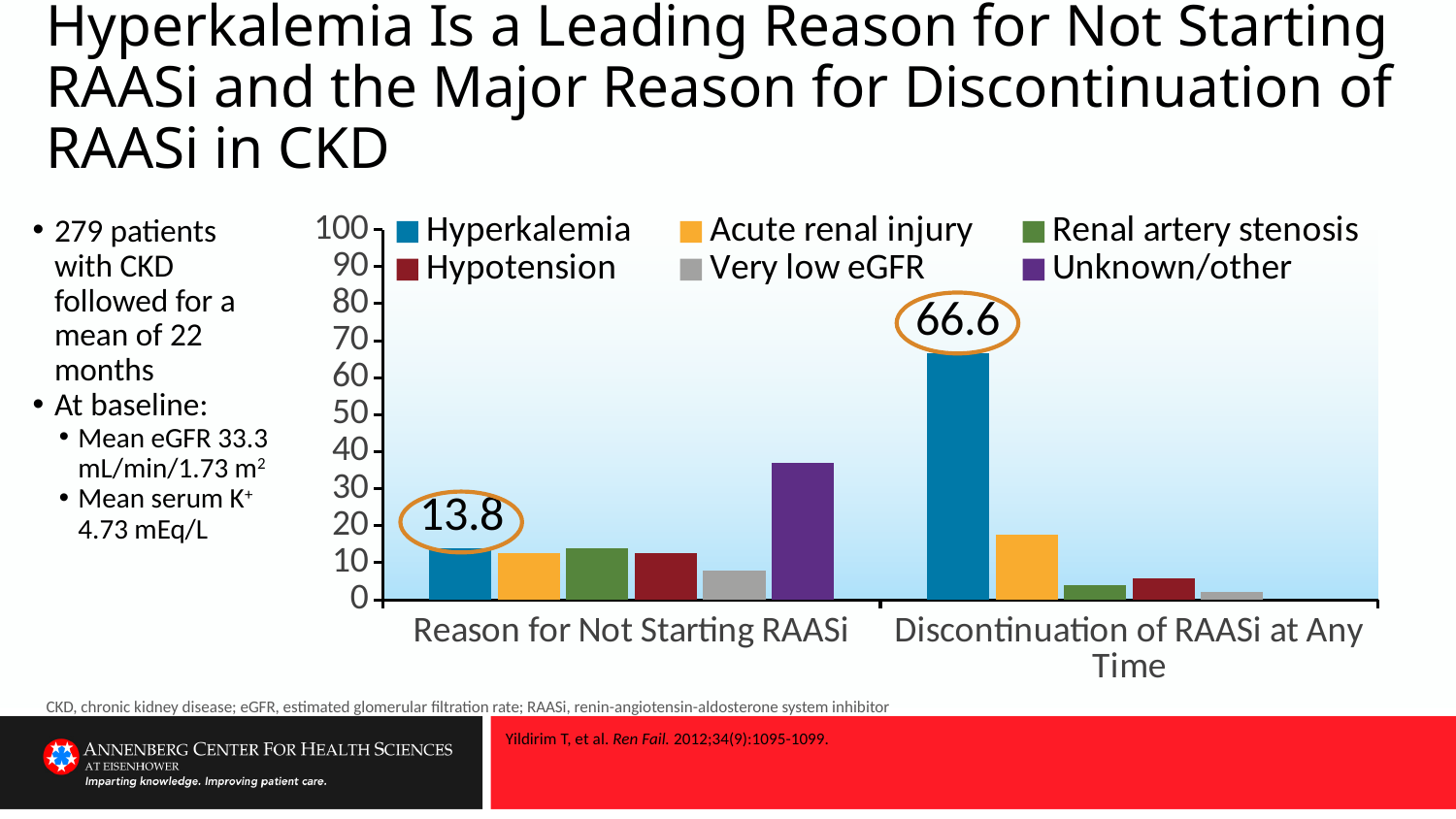
Is the value for Unknown/other in the Reason for Not Starting RAASi category greater or less than 30? greater Is the Hyperkalemia value larger for Reason for Not Starting RAASi or for Discontinuation of RAASi at Any Time? Discontinuation of RAASi at Any Time What is the difference between the Hyperkalemia values for Discontinuation of RAASi at Any Time and Reason for Not Starting RAASi? 52.8 What kind of chart is shown on the slide? Bar chart Which series has the highest value in the Discontinuation of RAASi at Any Time category? Hyperkalemia What is the value for Hyperkalemia in the Reason for Not Starting RAASi category? 13.8 Is the value for Acute renal injury in the Discontinuation of RAASi at Any Time category greater or less than 20? less Is the value for Renal artery stenosis in the Discontinuation of RAASi at Any Time category greater or less than 10? less Which series has the highest value in the Reason for Not Starting RAASi category? Unknown/other How many series does the legend list? 6 Which series has the lowest value in the Reason for Not Starting RAASi category? Very low eGFR What is the value for Hyperkalemia in the Discontinuation of RAASi at Any Time category? 66.6